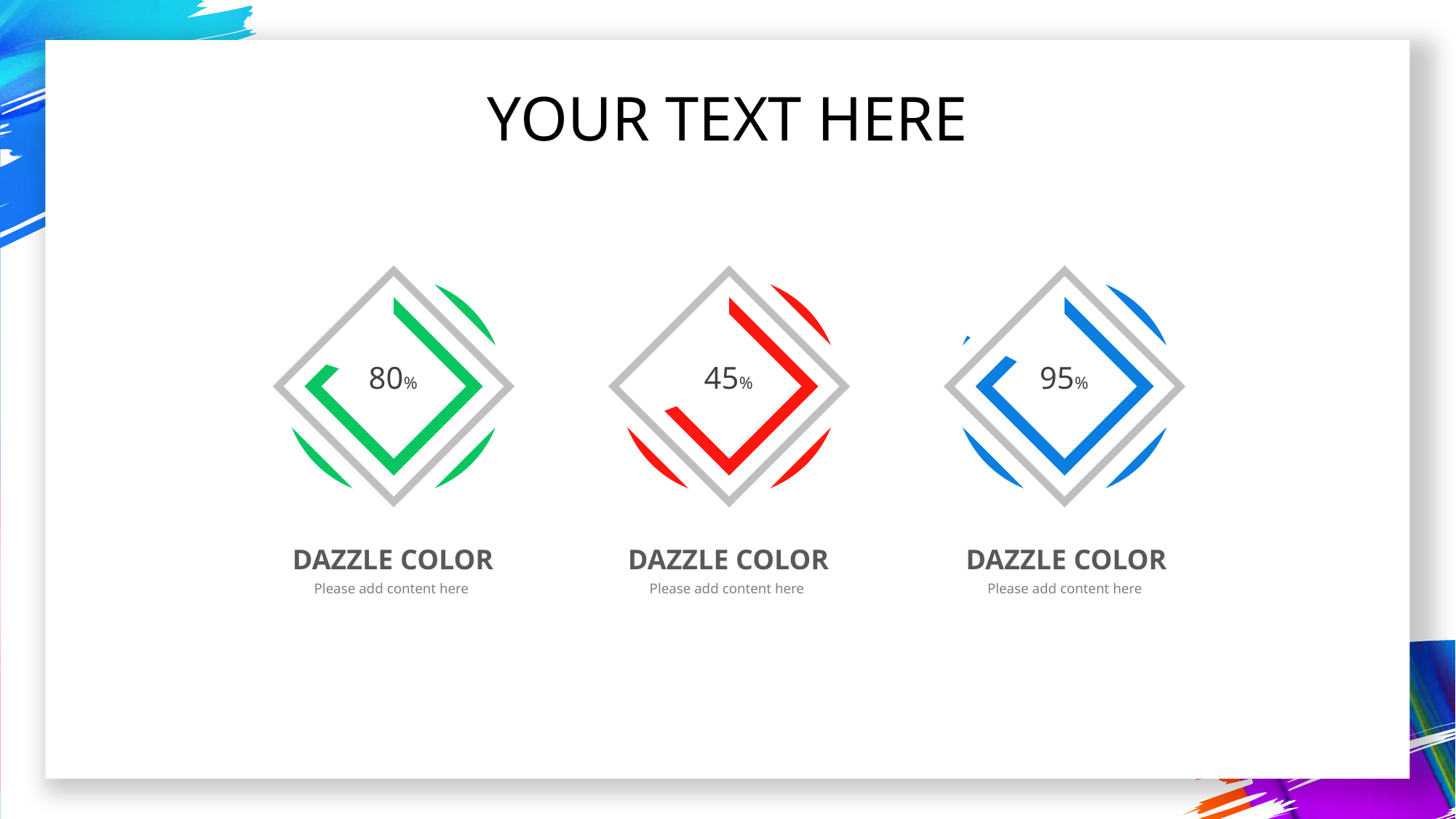
What is the difference between the percentages in the left and middle indicators? 35% How many percentage indicators are shown on the slide? 3 What colour is the indicator that shows 45%? red What percentage is shown in the middle (red) indicator? 45% What is the title of the slide? YOUR TEXT HERE Which of the three indicators shows the highest percentage: left, middle or right? right What percentage is shown in the right (blue) indicator? 95% Which of the three indicators shows the lowest percentage: left, middle or right? middle What percentage is shown in the left (green) indicator? 80% What is the difference between the percentages in the right and middle indicators? 50% Which is larger, the percentage in the green indicator or the percentage in the red indicator? green